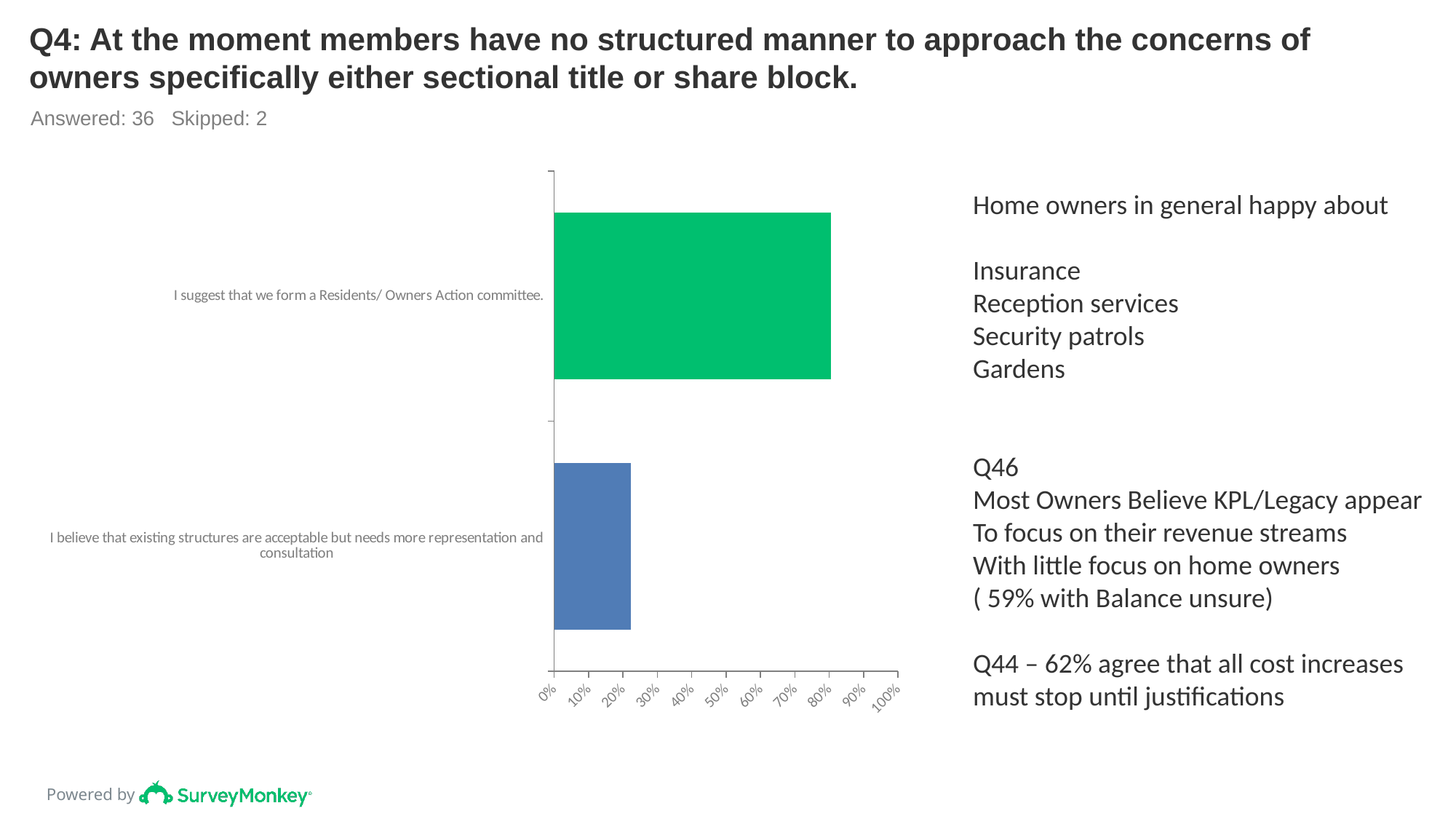
Is the value for 'I suggest that we form a Residents/ Owners Action committee.' greater or less than 90%? less What colour is the bar for 'I suggest that we form a Residents/ Owners Action committee.'? green Which category has the lowest value? I believe that existing structures are acceptable but needs more representation and consultation Which is larger: the value for 'I suggest that we form a Residents/ Owners Action committee.' or the value for 'I believe that existing structures are acceptable but needs more representation and consultation'? I suggest that we form a Residents/ Owners Action committee. Which category has the highest value? I suggest that we form a Residents/ Owners Action committee. What is the maximum value shown on the chart's percentage axis? 100% What kind of chart is shown on the slide? bar chart Is the value for 'I believe that existing structures are acceptable but needs more representation and consultation' greater or less than 30%? less How many categories (bars) does the chart show? 2 Is the value for 'I suggest that we form a Residents/ Owners Action committee.' greater or less than 70%? greater